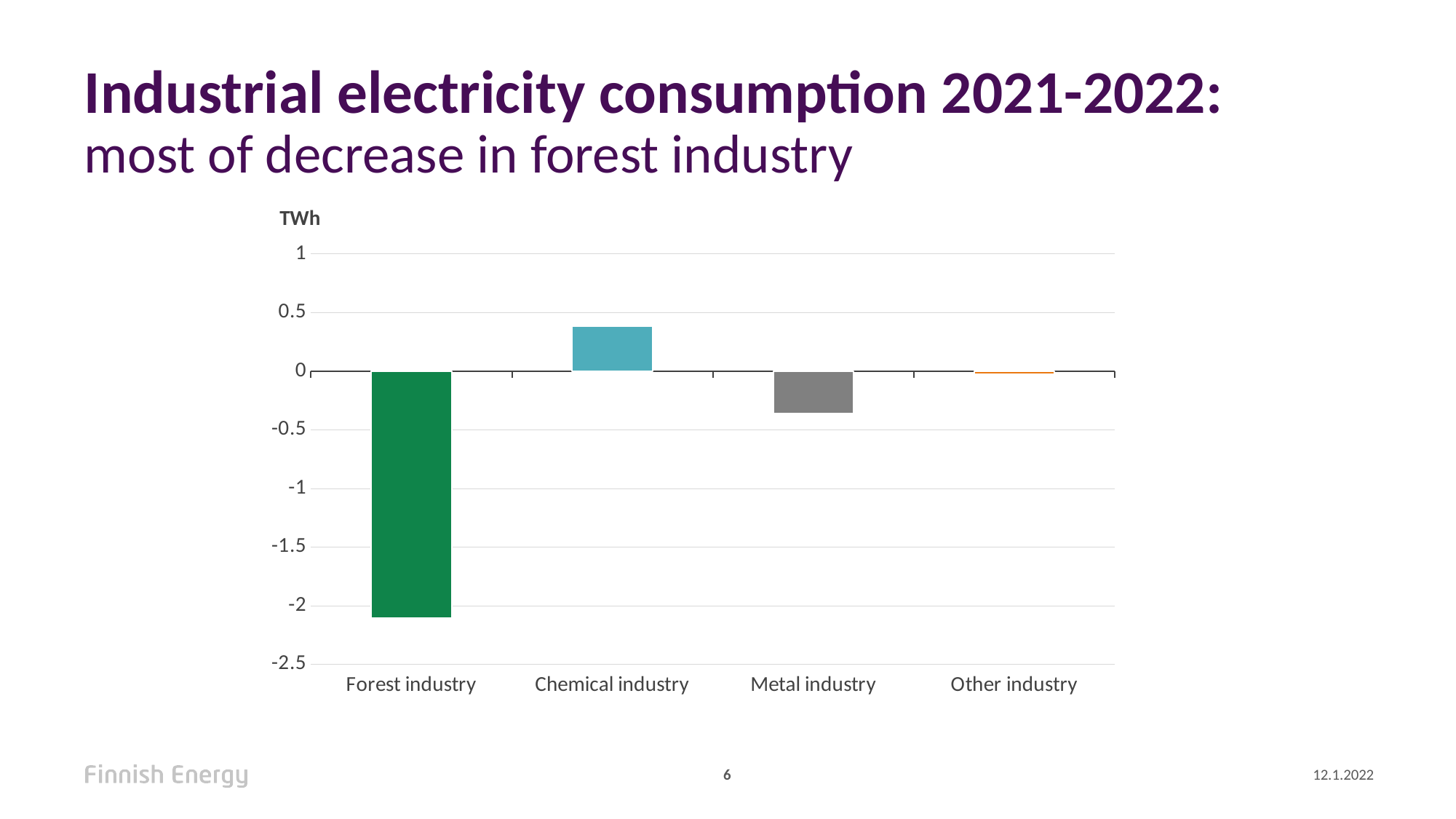
Is the value for Metal industry greater or less than 0? less Is the value for Chemical industry greater or less than 0? greater How many industry categories are shown on the x axis of the chart? 4 What unit is shown on the y axis of the chart? TWh What kind of chart is shown on the slide? bar chart Is the value for Chemical industry greater or less than 0.5? less Which is larger, the value for Forest industry or the value for Metal industry? Metal industry Which is larger, the value for Chemical industry or the value for Metal industry? Chemical industry Which industry has the highest value in the chart? Chemical industry Which industry has the lowest value in the chart? Forest industry